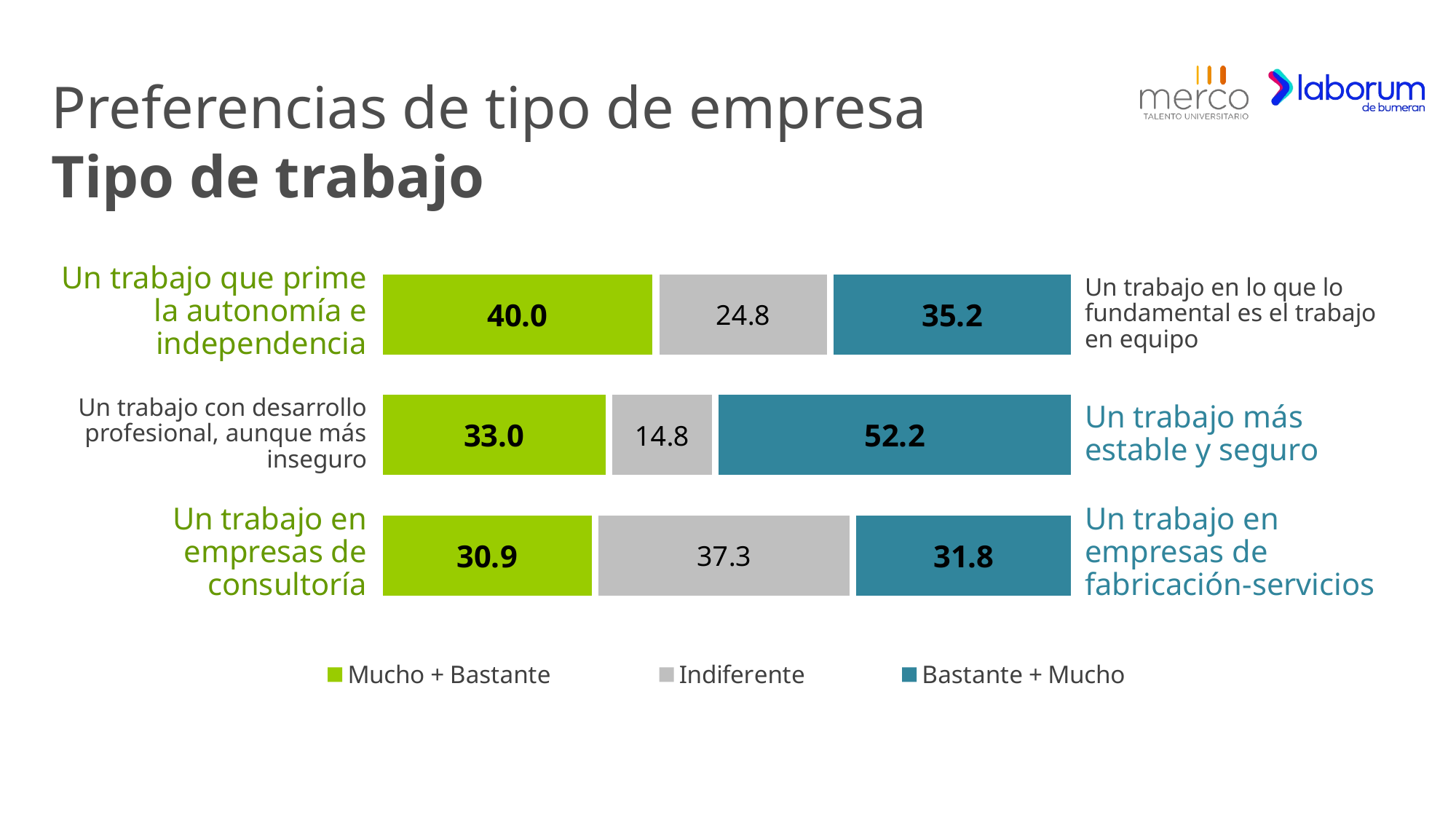
What colour represents the 'Indiferente' series in the legend? Grey How many series does the legend list? 3 What is the total of the three segments in the 'Un trabajo que prime la autonomía e independencia' row? 100.0 What is the difference between the 'Bastante + Mucho' value and the 'Mucho + Bastante' value in the 'Un trabajo con desarrollo profesional, aunque más inseguro' row? 19.2 Which row has the lowest 'Indiferente' value? Un trabajo con desarrollo profesional, aunque más inseguro In the 'Un trabajo en empresas de consultoría' row, which is larger: 'Mucho + Bastante' or 'Indiferente'? Indiferente What kind of chart is shown on the slide? Stacked bar chart How many rows (categories) does the chart show? 3 What is the 'Mucho + Bastante' value for 'Un trabajo que prime la autonomía e independencia'? 40.0 What is the 'Indiferente' value for 'Un trabajo con desarrollo profesional, aunque más inseguro'? 14.8 What is the 'Bastante + Mucho' value for 'Un trabajo en empresas de consultoría'? 31.8 Which row has the highest 'Bastante + Mucho' value? Un trabajo con desarrollo profesional, aunque más inseguro